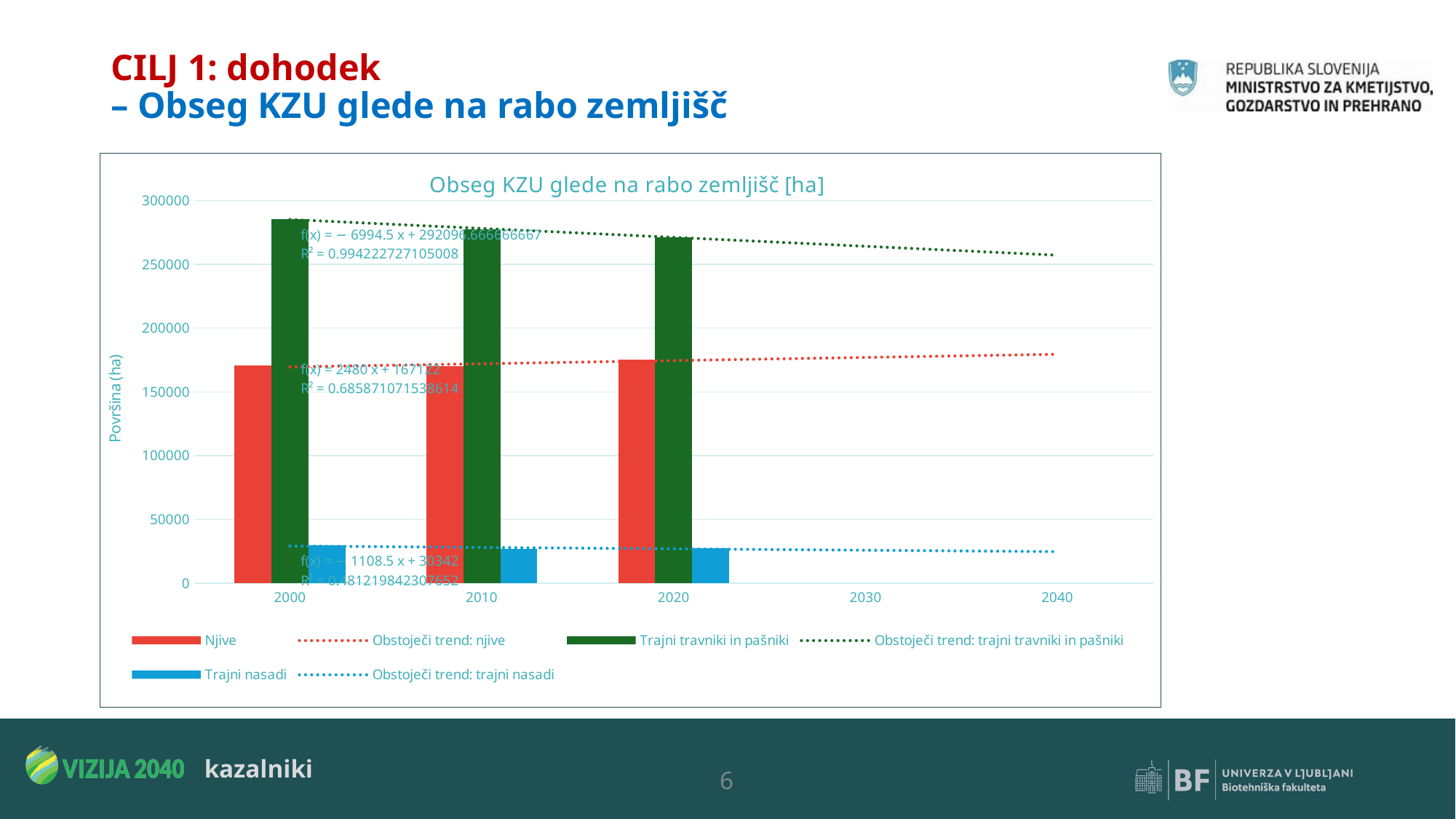
Which land-use category has the lowest value in 2020? Trajni nasadi Do the values for Trajni travniki in pašniki rise or fall from 2000 to 2020? fall Is the value for Njive in 2000 greater or less than 150000? greater How many entries does the chart legend list? 6 Is the value for Trajni nasadi in 2000 greater or less than 50000? less What kind of chart is shown on the slide? bar chart What is the title of the chart? Obseg KZU glede na rabo zemljišč [ha] What is the label of the vertical axis? Površina (ha) Is the value for Trajni travniki in pašniki larger in 2000 or in 2020? 2000 For how many years are bars plotted in the chart? 3 Is the value for Trajni travniki in pašniki in 2020 greater or less than 250000? greater Which land-use category has the highest value in 2000? Trajni travniki in pašniki